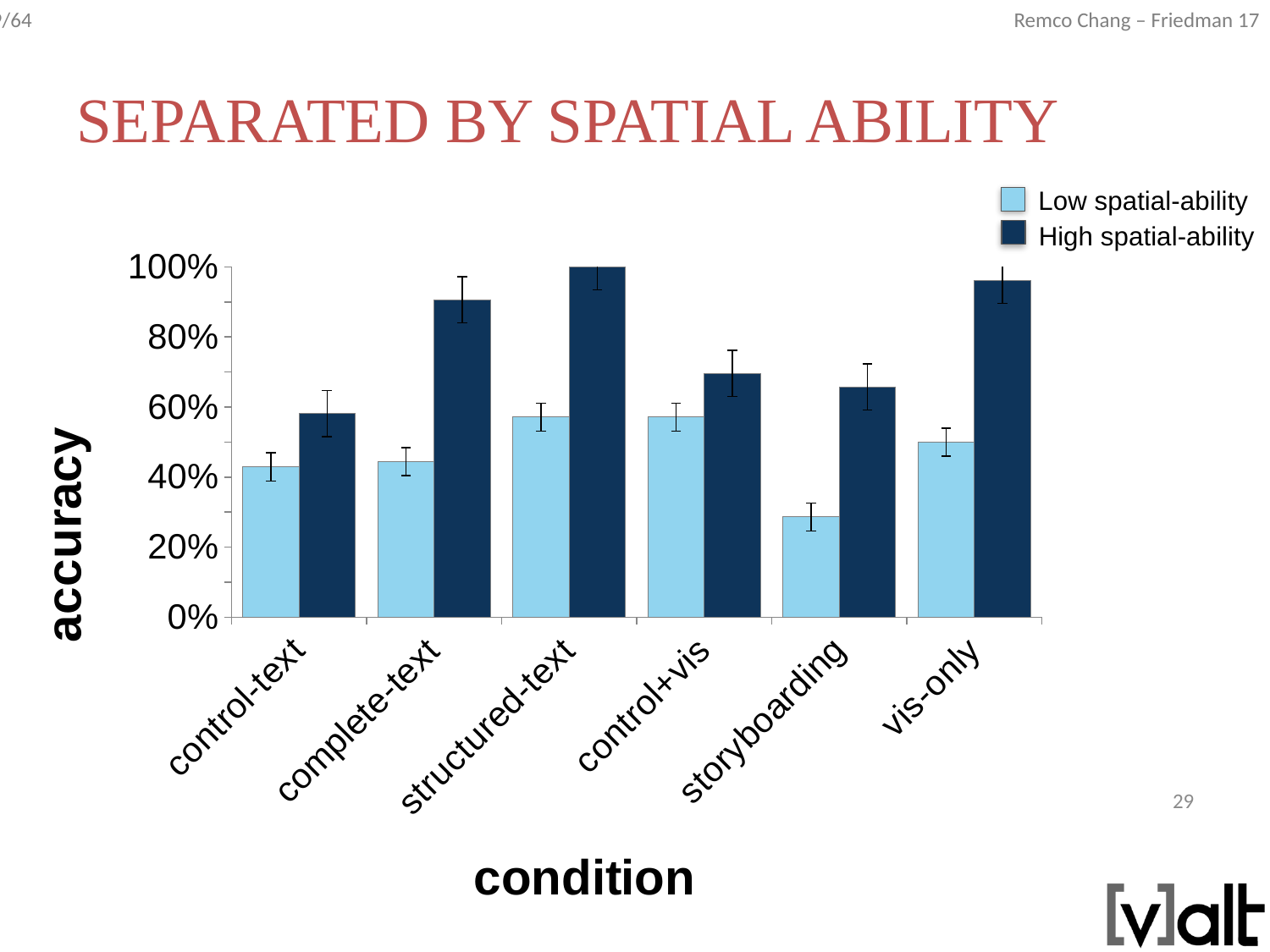
How many conditions are shown along the x axis? 6 What is the accuracy for High spatial-ability in the structured-text condition? 100% How many series does the legend list? 2 What is the label on the y axis of the chart? accuracy Is the High spatial-ability accuracy for vis-only greater or less than 80%? greater Is the Low spatial-ability accuracy for storyboarding greater or less than 40%? less What kind of chart is shown on the slide? bar chart For the complete-text condition, which series has the higher accuracy, Low spatial-ability or High spatial-ability? High spatial-ability Which condition has the highest accuracy for the High spatial-ability series? structured-text Is the High spatial-ability accuracy for complete-text greater or less than 80%? greater Which condition has the lowest accuracy for the Low spatial-ability series? storyboarding What is the title of the slide containing the chart? SEPARATED BY SPATIAL ABILITY